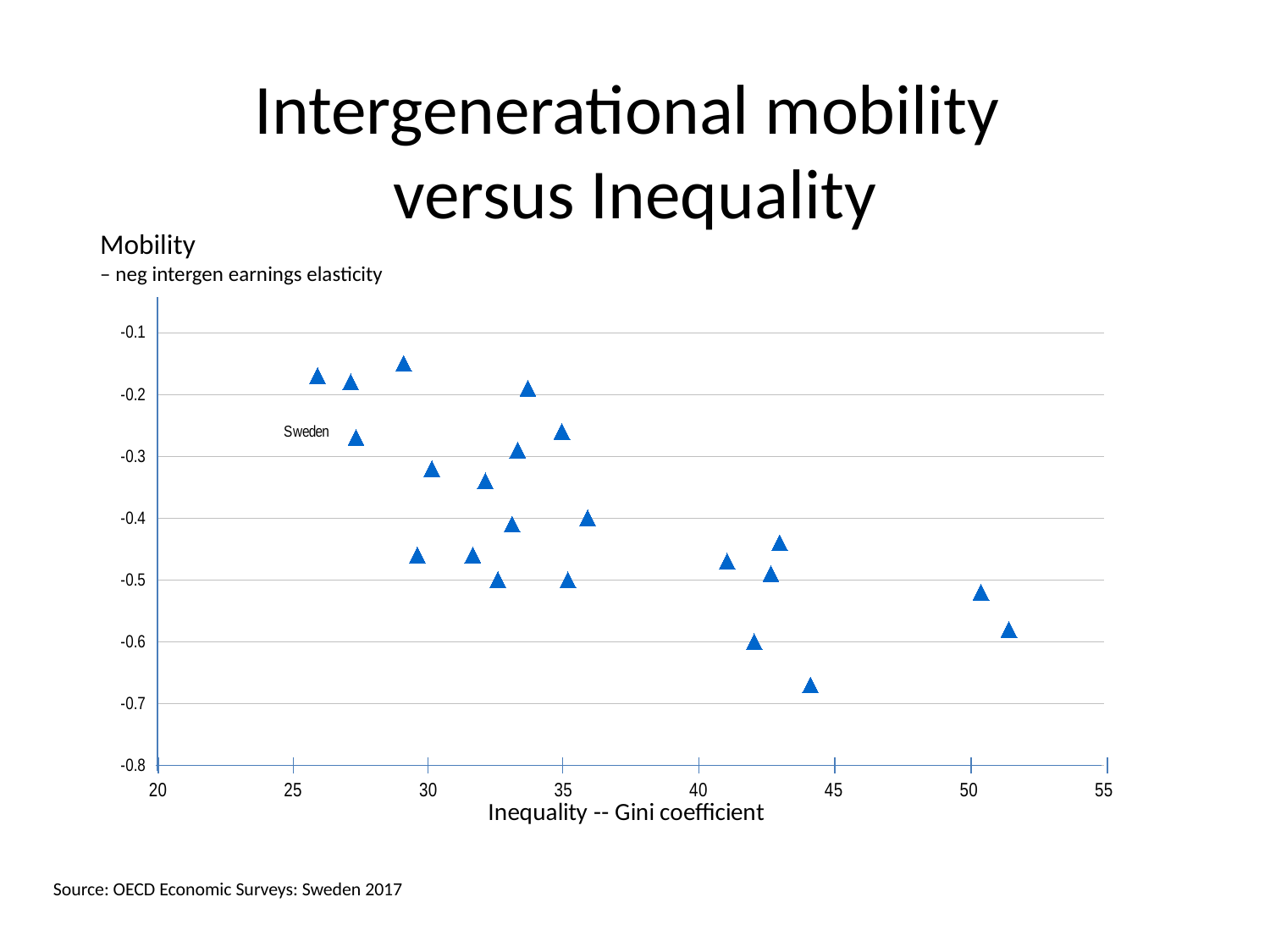
What is the title of the chart on the slide? Intergenerational mobility versus Inequality What is the label of the x axis? Inequality -- Gini coefficient Is the highest mobility value plotted on the chart greater or less than -0.2? greater What kind of chart is shown on the slide? Scatter plot Which country is labelled on the chart? Sweden Is the mobility value of the point with the highest Gini coefficient greater or less than -0.5? less How many data points are plotted on the chart? 22 As inequality (Gini coefficient) increases along the x axis, does mobility generally rise or fall? fall Is the lowest mobility value plotted on the chart greater or less than -0.6? less